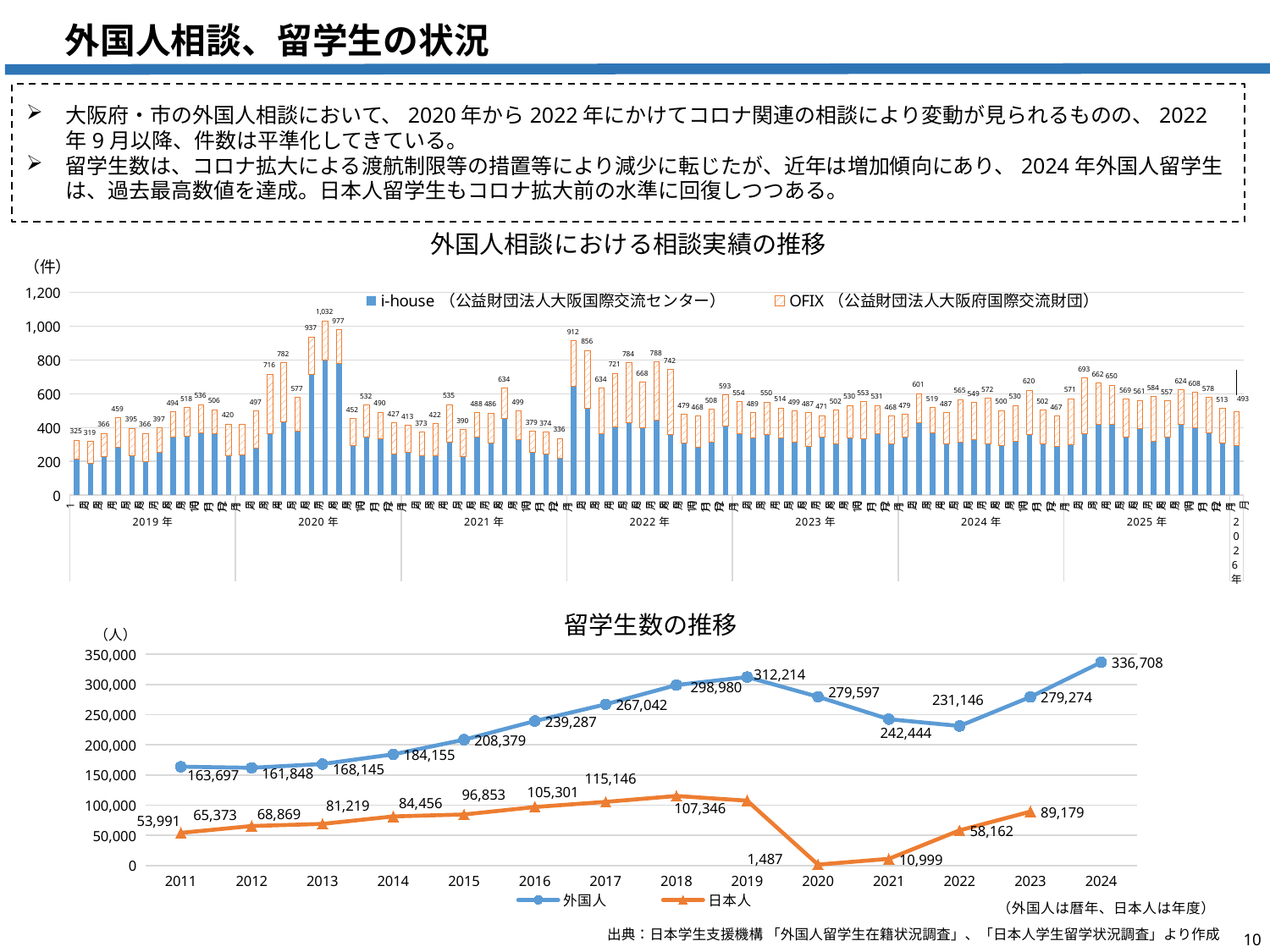
In the 留学生数の推移 chart, which year has the lowest value for 外国人? 2012 In the 外国人相談における相談実績の推移 chart, what is the highest monthly total shown? 1,032 In the 留学生数の推移 chart, what is the value for 外国人 in 2024? 336,708 In the 留学生数の推移 chart, what is the value for 日本人 in 2020? 1,487 What kind of chart is 外国人相談における相談実績の推移? stacked bar chart In the 留学生数の推移 chart, how many series does the legend list? 2 In the 留学生数の推移 chart, what is the value for 外国人 in 2019? 312,214 In the 留学生数の推移 chart, how many years are plotted for the 外国人 series? 14 In the 留学生数の推移 chart, does the 外国人 series rise or fall from 2011 to 2019? rise In the 留学生数の推移 chart, what is the difference between the 外国人 values for 2024 and 2019? 24,494 In the 留学生数の推移 chart, which is larger: the 外国人 value for 2020 or for 2023? 2020 In the 留学生数の推移 chart, which year has the highest value for 日本人? 2018